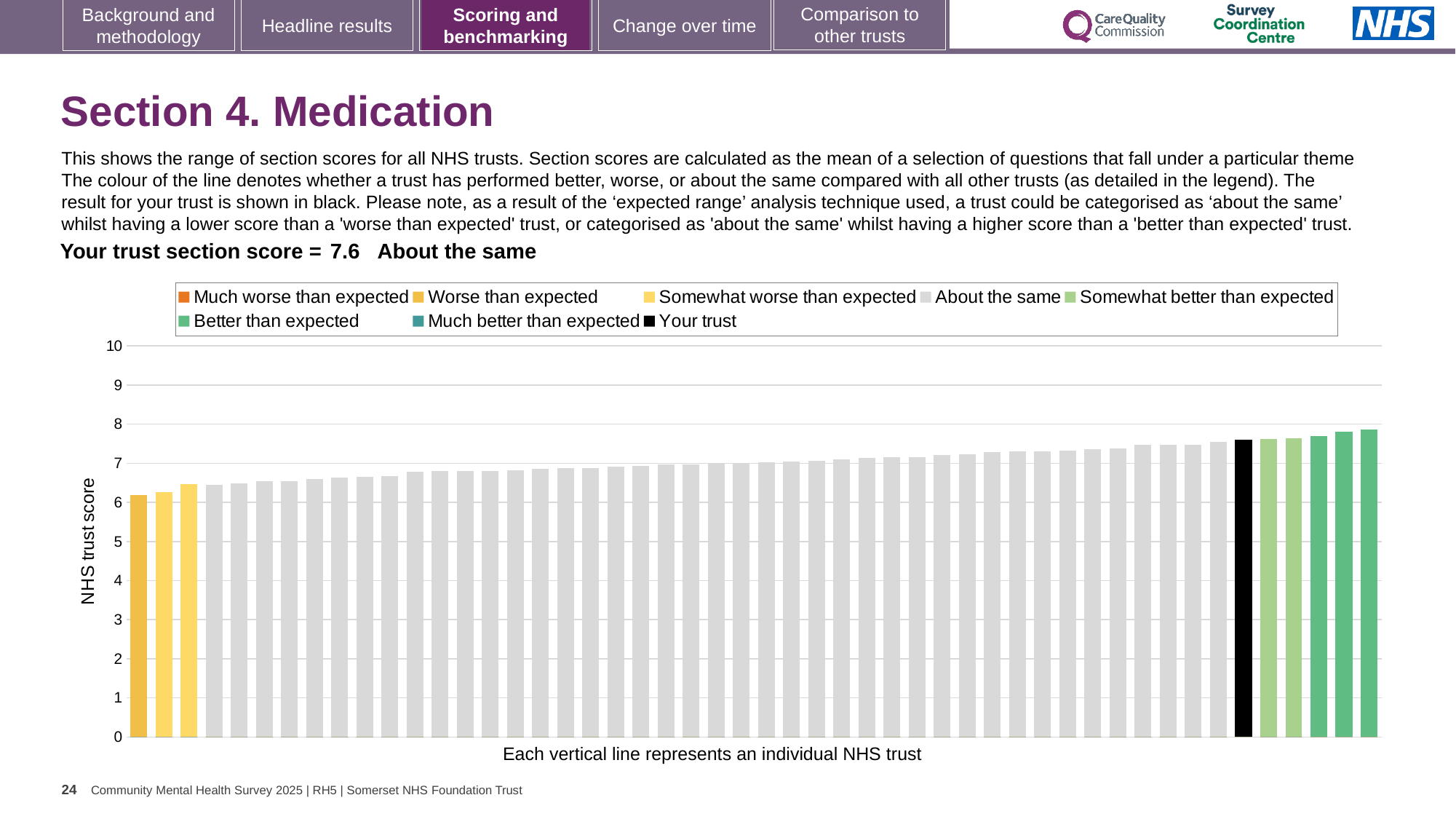
How many entries does the chart legend list? 8 Is the value of the highest bar in the chart greater or less than 7? greater Do the bar values rise or fall from left to right across the chart? rise How many bars at the left of the chart are coloured yellow/orange? 3 Which is larger: the score for your trust (black bar) or the score of the leftmost bar? your trust What is the label on the vertical axis of the chart? NHS trust score What is the section score for your trust shown on the slide? 7.6 Is the value of the lowest bar in the chart greater or less than 7? less Is the value of the lowest bar in the chart greater or less than 6? greater What kind of chart is shown on the slide? bar chart How many bars to the right of the black 'Your trust' bar are coloured green? 5 What colour is the bar representing your trust? black